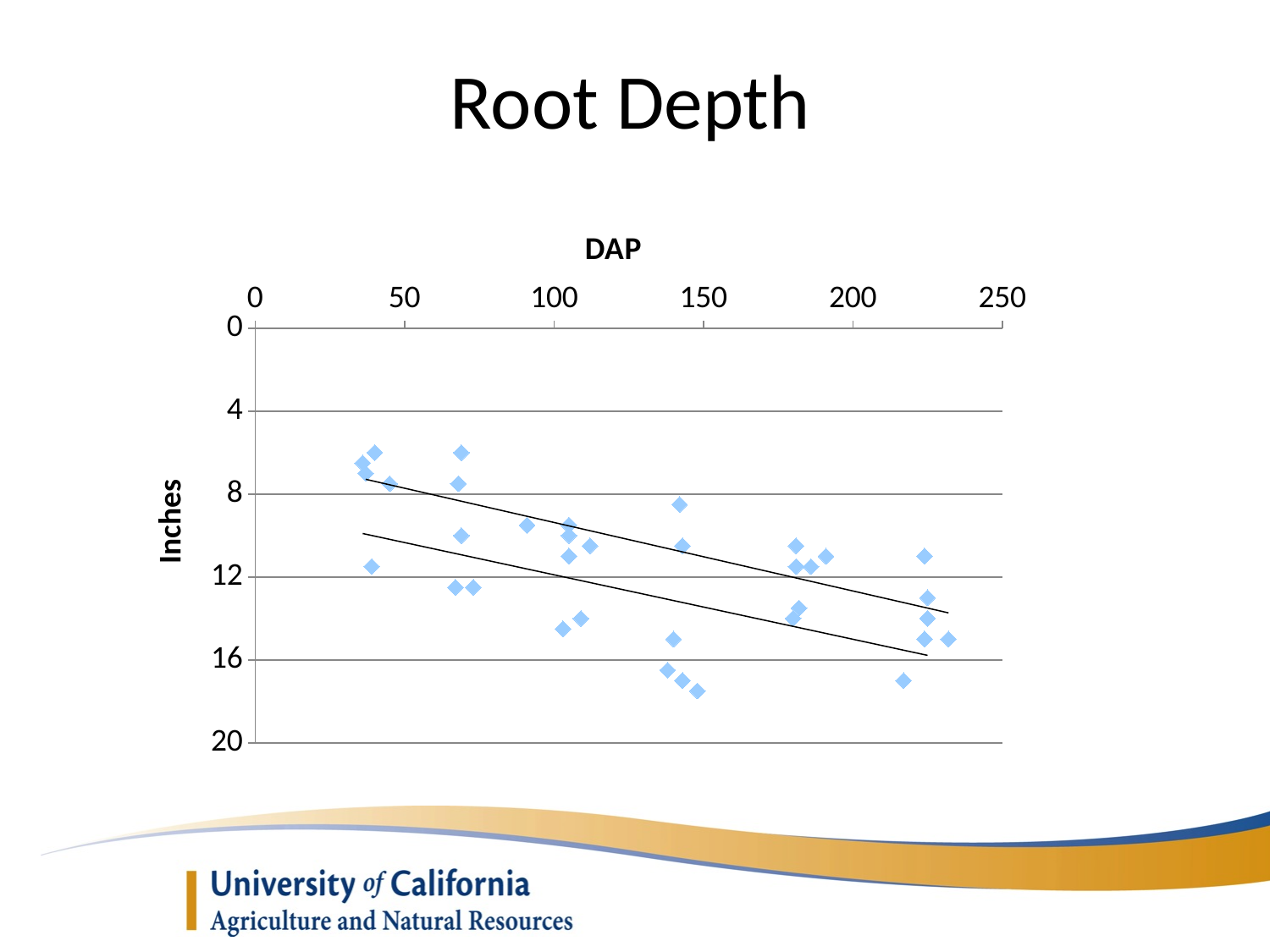
How many trend lines are drawn through the scatter points? 2 Is the largest root depth value plotted (the point near DAP 150) greater or less than 16 inches? greater What is the title of the horizontal axis of the chart? DAP What kind of chart is shown on the slide? scatter chart Is the smallest root depth value plotted (near DAP 40) greater or less than 8 inches? less Is the root depth of the point plotted near DAP 40 at the lowest position greater or less than 12 inches? less As DAP increases, do the root depth values in inches generally increase or decrease? increase What is the title of the vertical axis of the chart? Inches What is the highest value shown on the DAP axis? 250